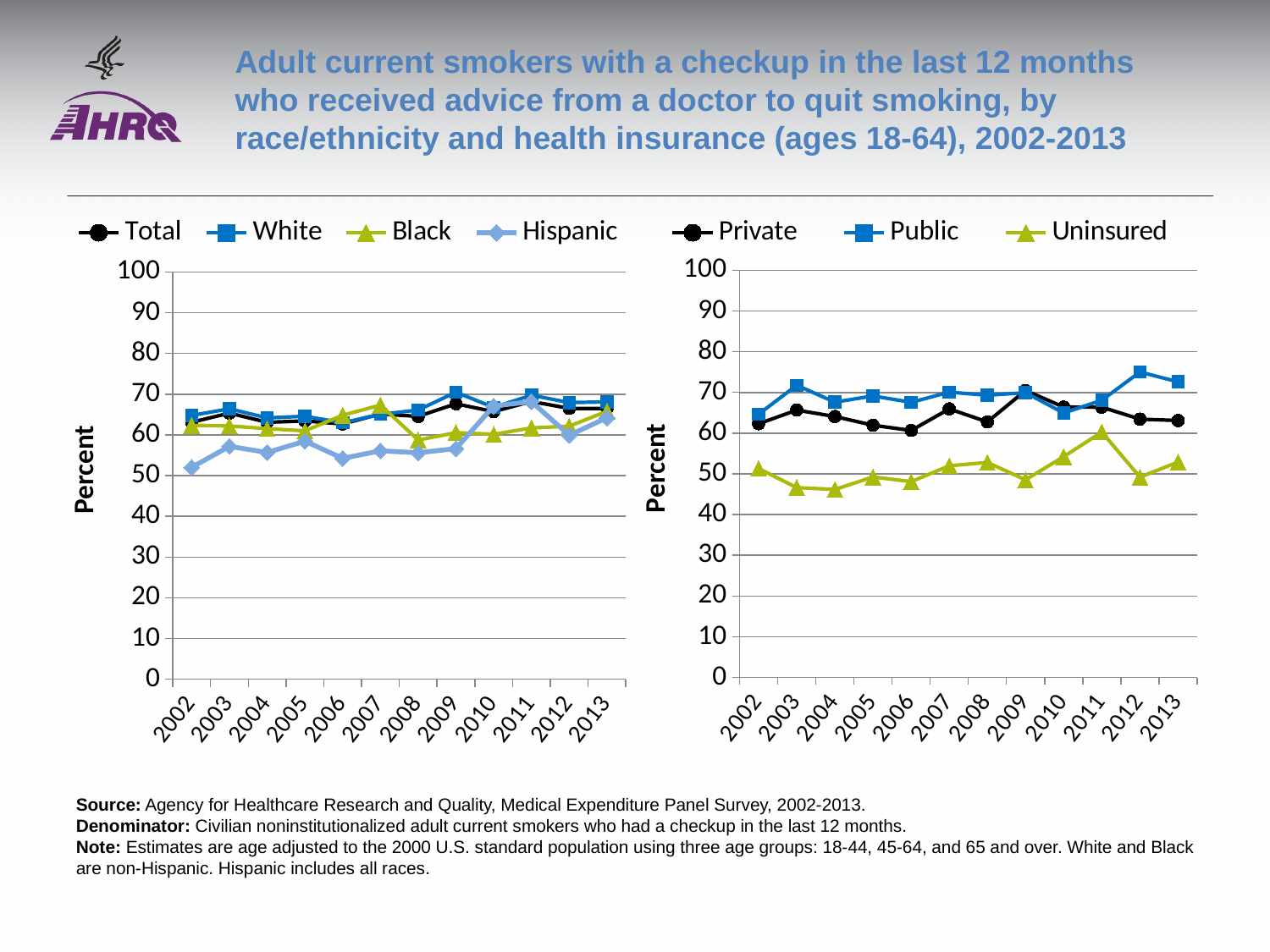
In the left chart (by race/ethnicity), does the Hispanic line rise or fall from 2002 to 2013? rise In the left chart (by race/ethnicity), is the value for Hispanic in 2002 greater or less than 60? less What kind of chart is the left chart (by race/ethnicity)? line chart In the right chart (by health insurance), is the value for Uninsured in 2004 greater or less than 50? less What is the label on the y axis of the right chart (by health insurance)? Percent How many years are shown on the x axis of the right chart (by health insurance)? 12 In the right chart (by health insurance), which series has the highest value in 2012? Public In the left chart (by race/ethnicity), which is larger in 2002, White or Hispanic? White In the right chart (by health insurance), is the value for Public in 2012 greater or less than 70? greater How many series does the legend of the left chart (by race/ethnicity) list? 4 How many series does the legend of the right chart (by health insurance) list? 3 In the right chart (by health insurance), which series has the lowest value in 2004? Uninsured